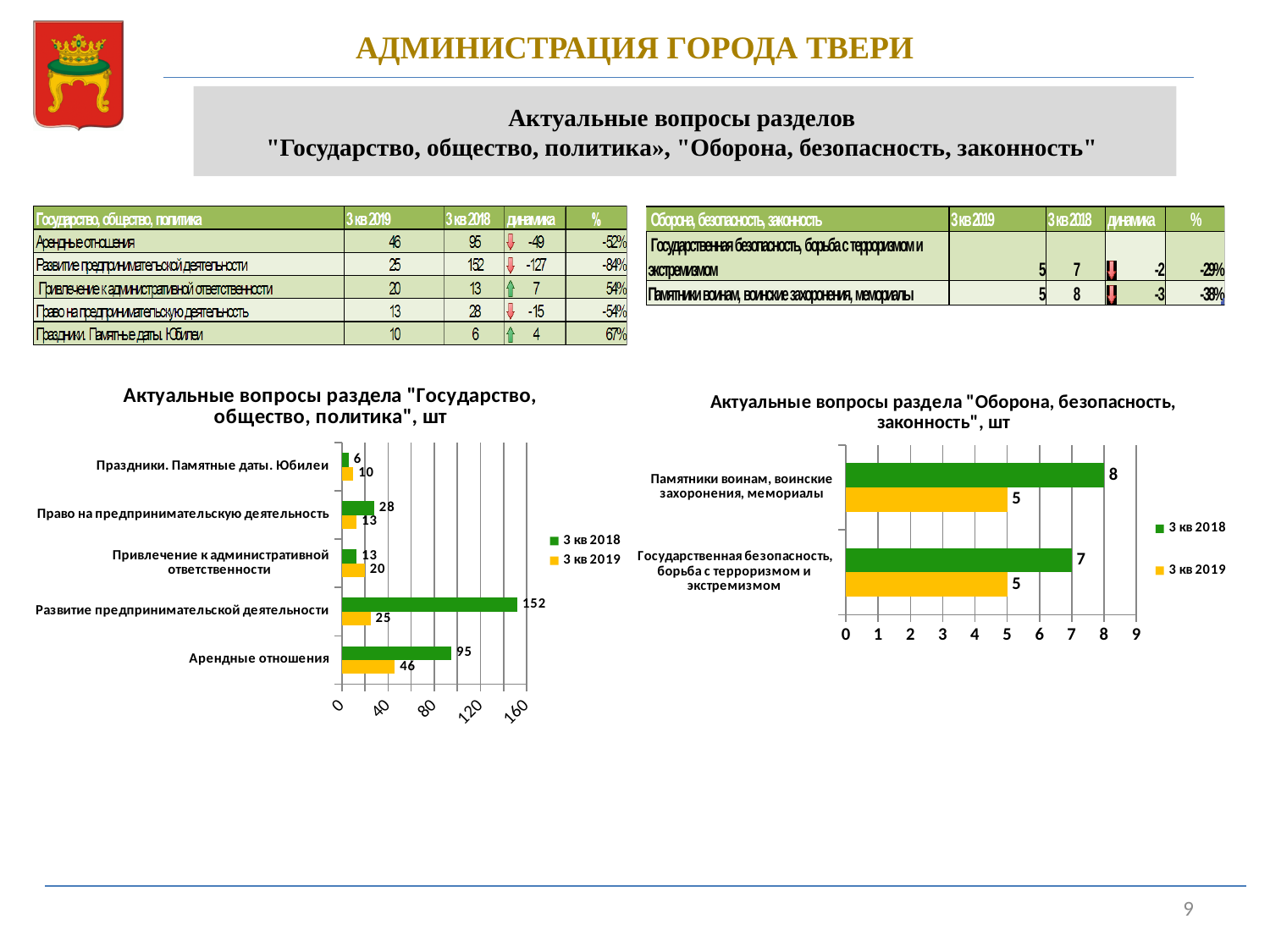
In the chart "Актуальные вопросы раздела "Государство, общество, политика", шт", which category has the highest value for 3 кв 2018? Развитие предпринимательской деятельности In the chart "Актуальные вопросы раздела "Государство, общество, политика", шт", how many categories are shown? 5 In the chart "Актуальные вопросы раздела "Государство, общество, политика", шт", how many series does the legend list? 2 In the chart "Актуальные вопросы раздела "Государство, общество, политика", шт", what is the value for Развитие предпринимательской деятельности in 3 кв 2018? 152 In the chart "Актуальные вопросы раздела "Оборона, безопасность, законность", шт", which colour represents the 3 кв 2019 series? Yellow In the chart "Актуальные вопросы раздела "Государство, общество, политика", шт", what is the difference between the 3 кв 2018 and 3 кв 2019 values for Арендные отношения? 49 In the chart "Актуальные вопросы раздела "Государство, общество, политика", шт", which is larger for Привлечение к административной ответственности: 3 кв 2018 or 3 кв 2019? 3 кв 2019 In the chart "Актуальные вопросы раздела "Оборона, безопасность, законность", шт", what is the value for Памятники воинам, воинские захоронения, мемориалы in 3 кв 2018? 8 In the chart "Актуальные вопросы раздела "Оборона, безопасность, законность", шт", what is the difference between the 3 кв 2018 and 3 кв 2019 values for Государственная безопасность, борьба с терроризмом и экстремизмом? 2 What kind of chart is "Актуальные вопросы раздела "Оборона, безопасность, законность", шт"? Bar chart In the chart "Актуальные вопросы раздела "Государство, общество, политика", шт", what is the value for Арендные отношения in 3 кв 2019? 46 In the chart "Актуальные вопросы раздела "Государство, общество, политика", шт", which category has the lowest value for 3 кв 2018? Праздники. Памятные даты. Юбилеи